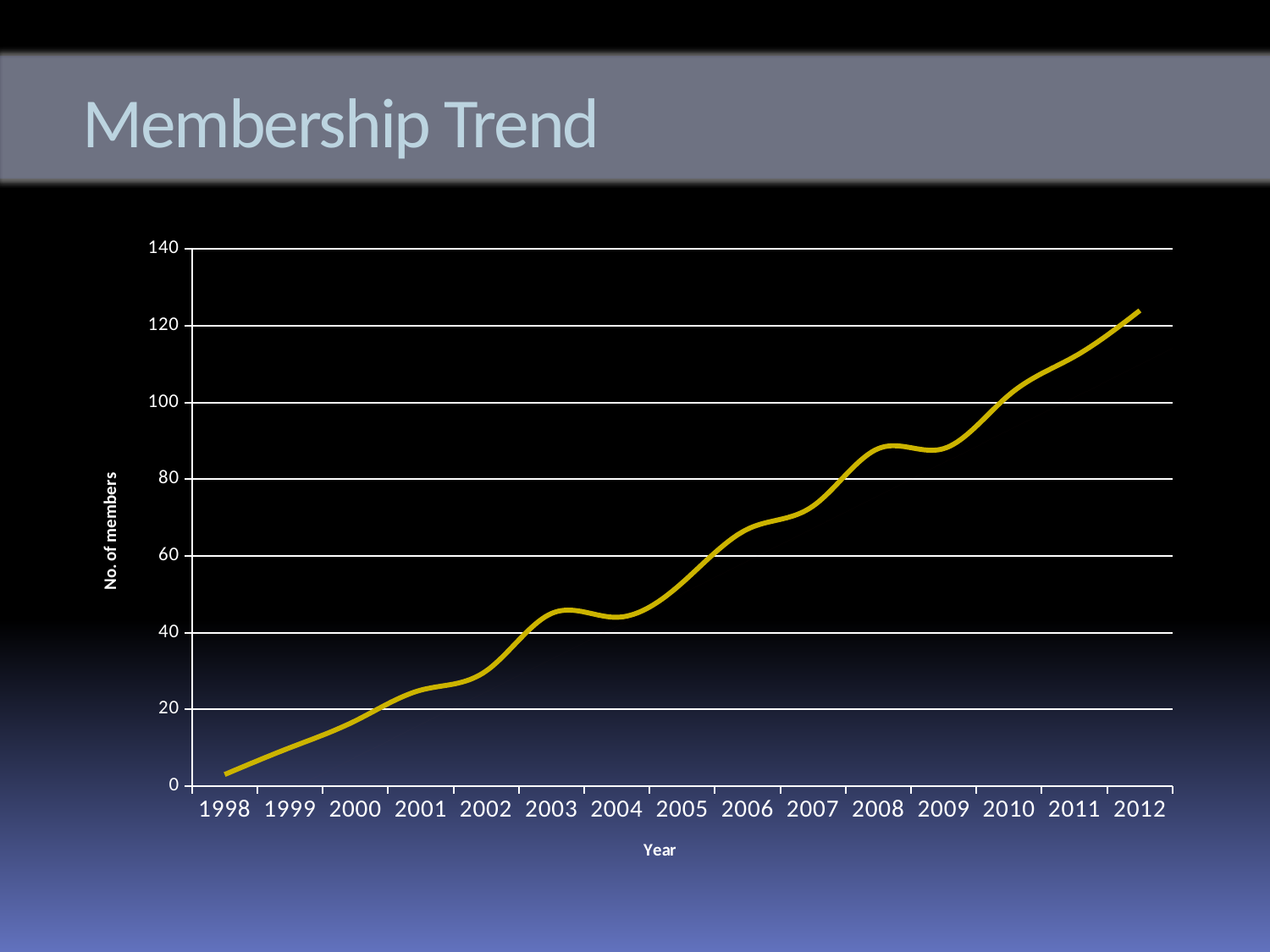
Is the value for 2012 greater or less than 120? greater Which year has the highest number of members? 2012 How many years are plotted on the x axis? 15 What is the title of the x axis? Year Which year has more members, 2007 or 2004? 2007 Is the value for 2006 greater or less than 60? greater Which year has the lowest number of members? 1998 Is the value for 1998 greater or less than 20? less What is the title of the y axis? No. of members What kind of chart is shown on the slide? Line chart Do the values generally rise or fall from 1998 to 2012? Rise